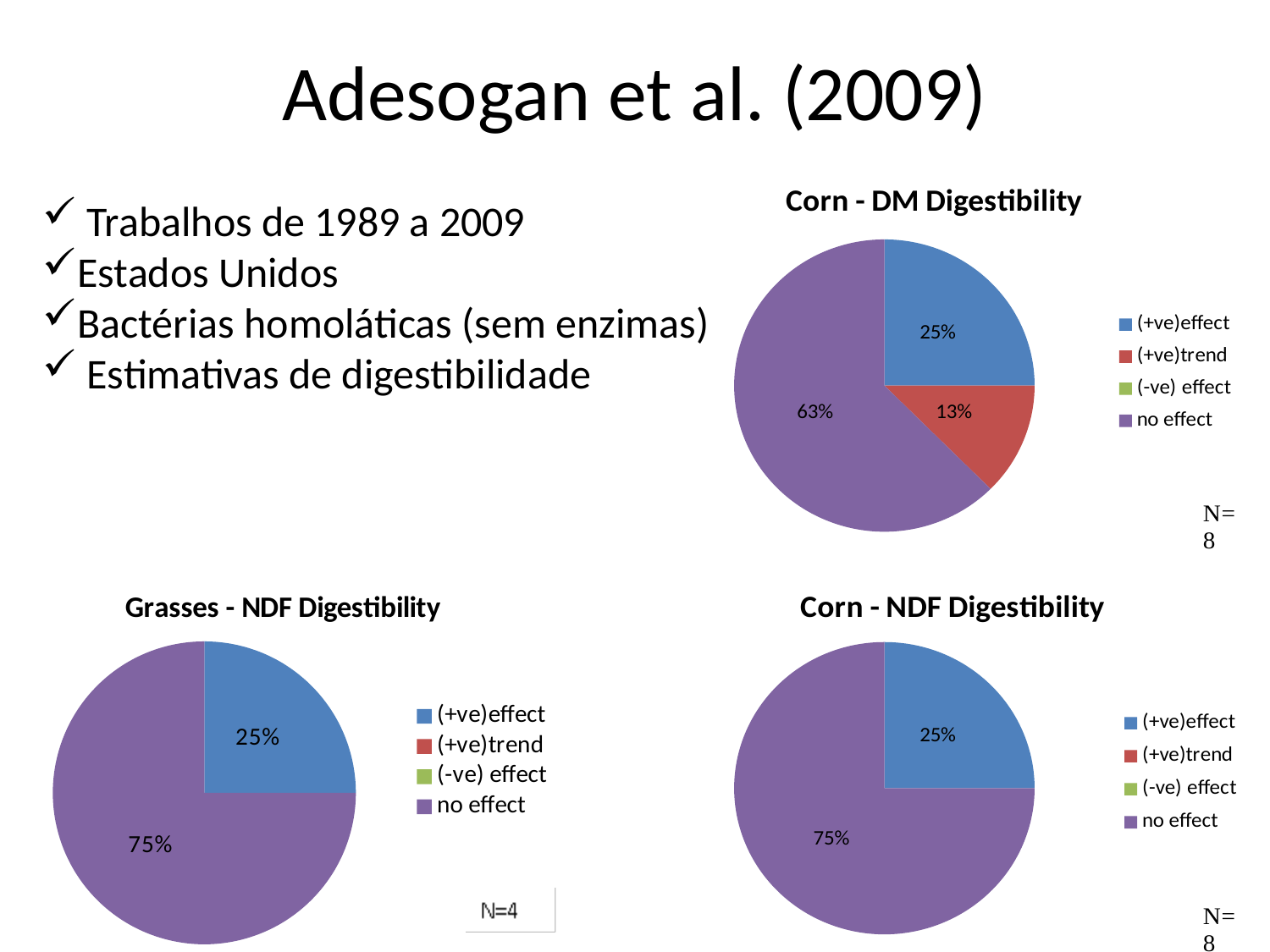
In the Corn - DM Digestibility chart, which category has the largest slice? no effect In the Corn - DM Digestibility chart, which of the plotted slices is the smallest? (+ve)trend In the Corn - DM Digestibility chart, what is the difference between the (+ve)effect share and the (+ve)trend share? 12% In the Corn - NDF Digestibility chart, what share does the no effect slice have? 75% In the Corn - DM Digestibility chart, what share does the (+ve)trend slice have? 13% What N value is shown next to the Grasses - NDF Digestibility chart? N=4 What kind of chart is the Corn - NDF Digestibility chart? pie chart In the Corn - NDF Digestibility chart, how many slices are visible in the pie? 2 In the Corn - DM Digestibility chart, what share does the no effect slice have? 63% In the Grasses - NDF Digestibility chart, which is larger, the no effect slice or the (+ve)effect slice? no effect How many entries does the legend of the Grasses - NDF Digestibility chart list? 4 In the Grasses - NDF Digestibility chart, what share does the (+ve)effect slice have? 25%